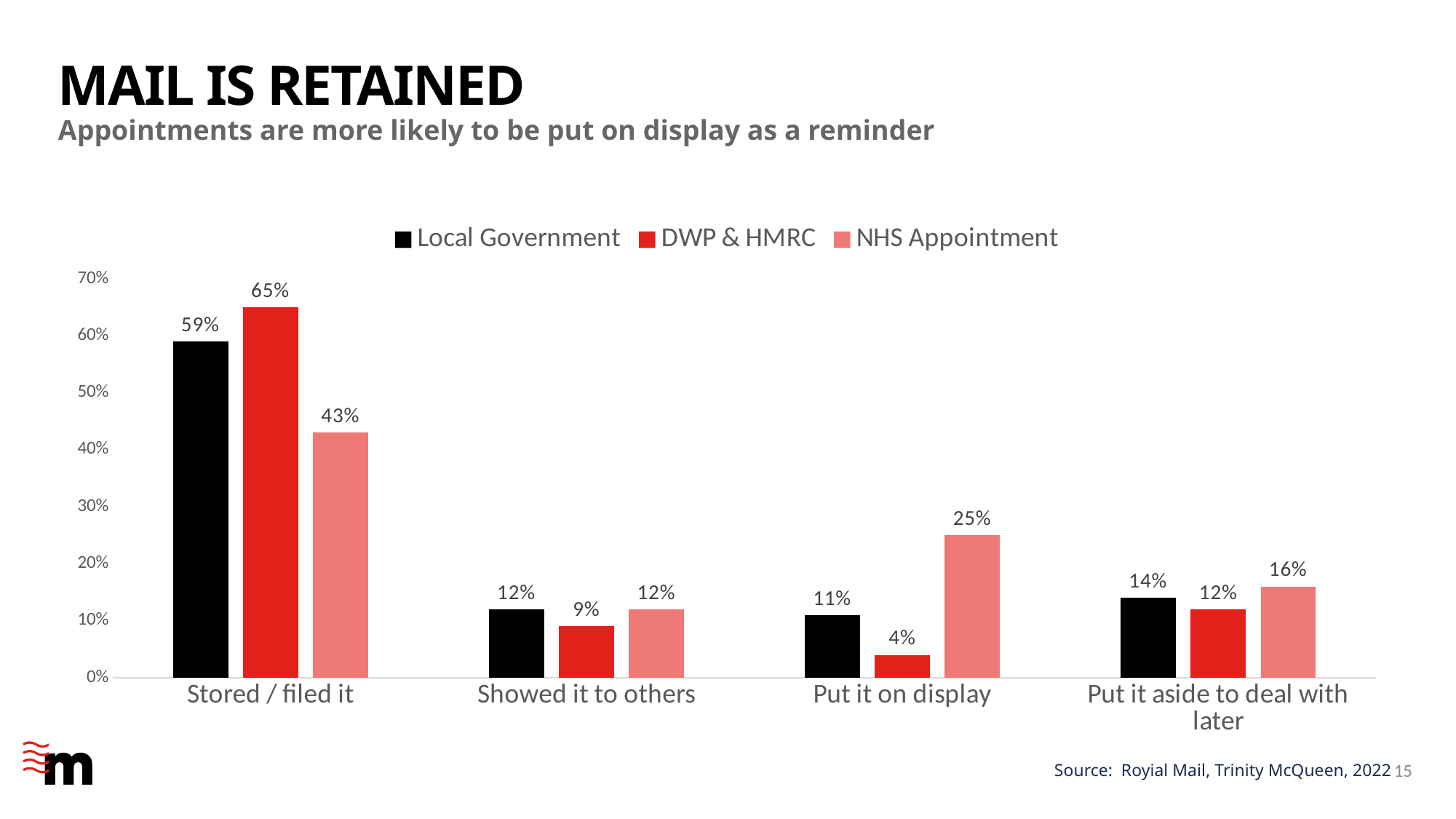
Which category has the highest value for NHS Appointment? Stored / filed it What is the value for Local Government in the 'Put it aside to deal with later' category? 14% What kind of chart is shown on the slide? Bar chart Which category has the lowest value for DWP & HMRC? Put it on display Which series is shown in black in the legend? Local Government How many series does the legend list? 3 What is the value for NHS Appointment in the 'Put it on display' category? 25% What is the difference between the DWP & HMRC and Local Government values in the 'Stored / filed it' category? 6% How many categories are shown on the x axis? 4 In the 'Put it aside to deal with later' category, which series has the larger value: Local Government or NHS Appointment? NHS Appointment What is the difference between the NHS Appointment and DWP & HMRC values in the 'Put it on display' category? 21% What is the value for DWP & HMRC in the 'Stored / filed it' category? 65%